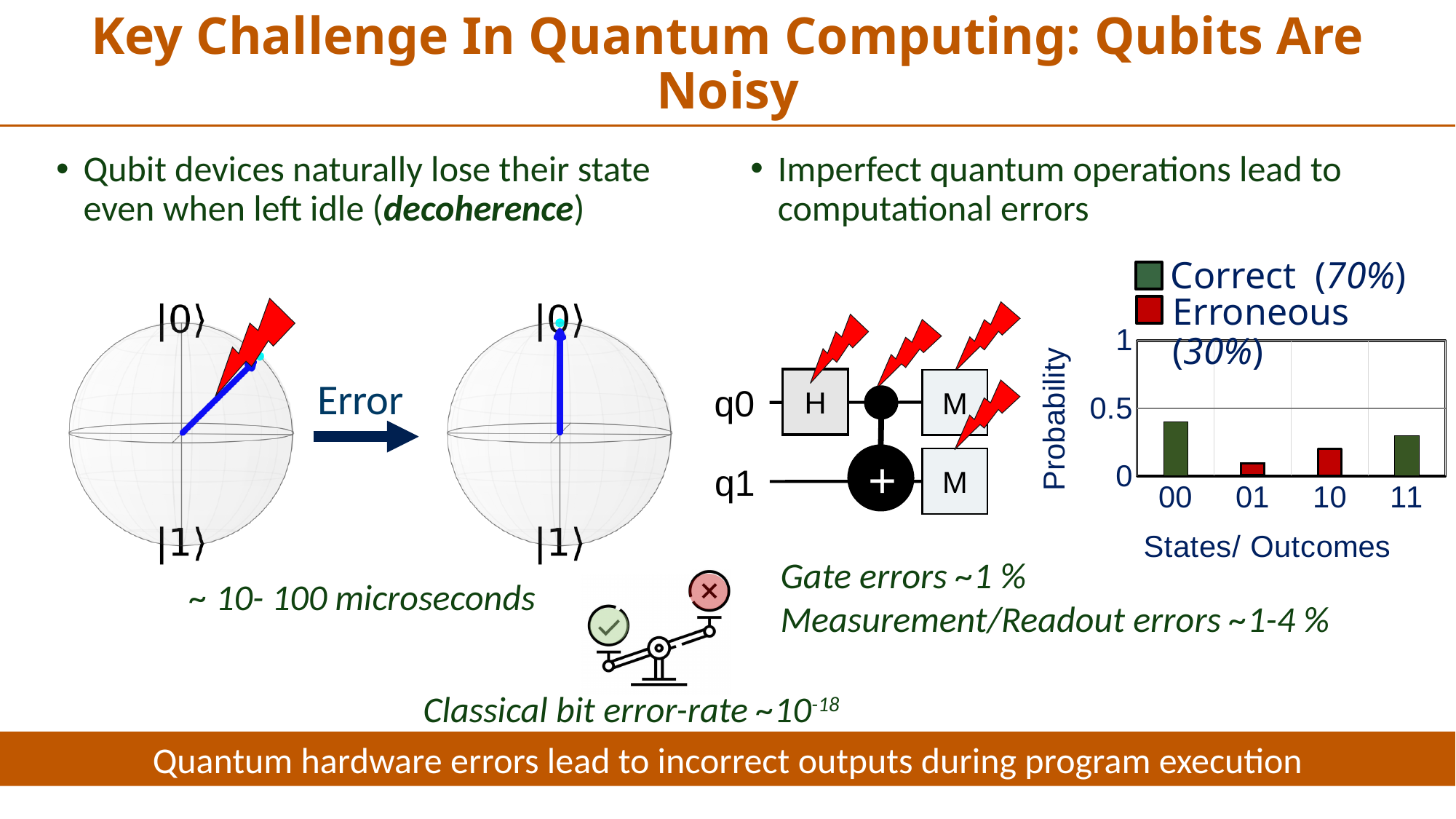
Which state/outcome has the highest probability in the bar chart? 00 In the probability bar chart, which has the larger probability, state 10 or state 11? 11 What percentage does the legend give for the 'Erroneous' series in the bar chart? 30% What is the label of the y axis of the bar chart? Probability How many series does the legend of the probability bar chart list? 2 What kind of chart is shown on the right side of the slide under the 'Correct'/'Erroneous' legend? bar chart In the probability bar chart, is the value for state 11 greater or less than 0.5? less Which state/outcome has the lowest probability in the bar chart? 01 In the probability bar chart, which has the larger probability, state 00 or state 01? 00 In the probability bar chart, is the value for state 00 greater or less than 0.5? less How many states/outcomes are shown on the x axis of the probability bar chart? 4